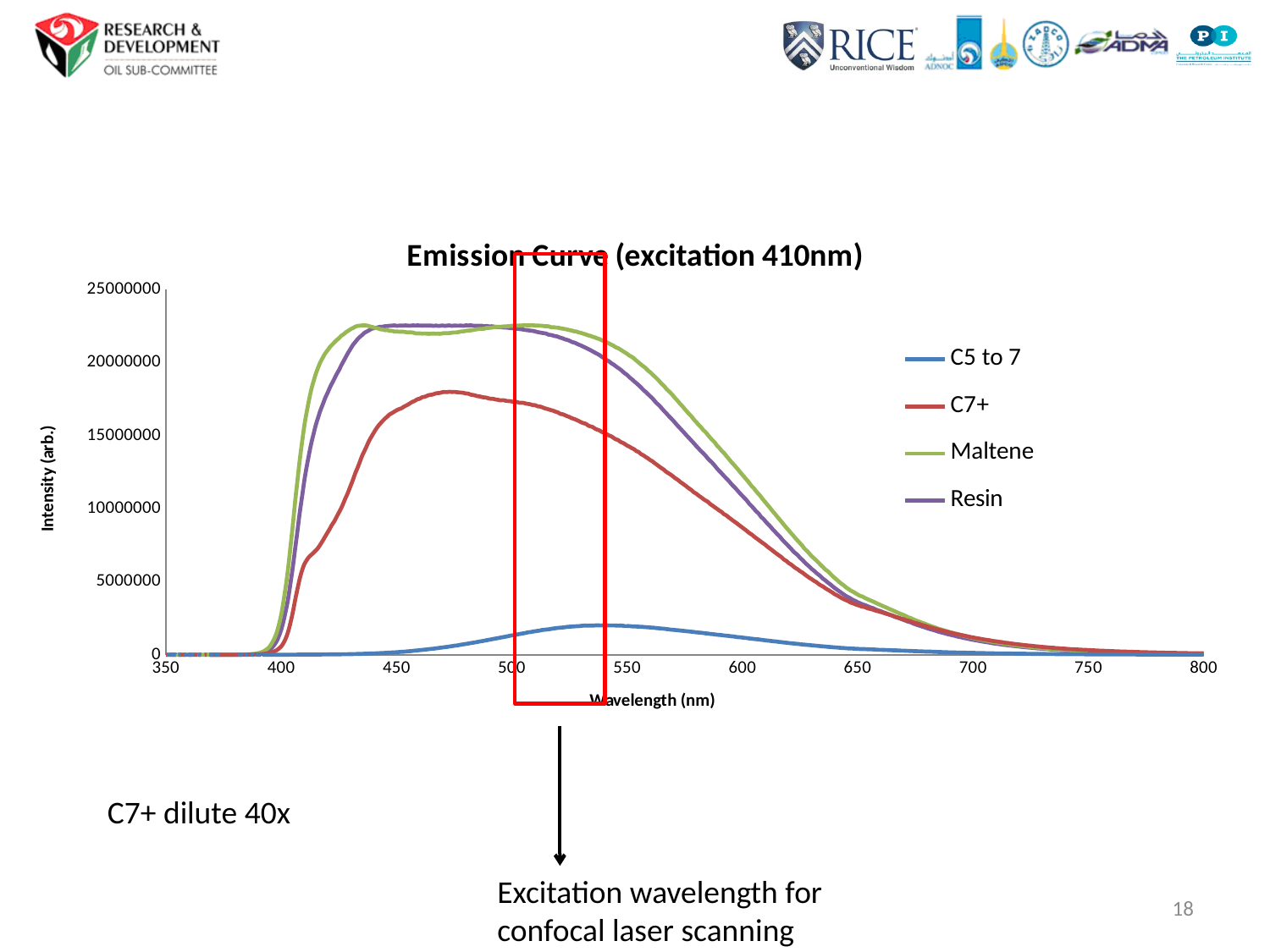
Is the intensity of the C7+ series at 600 nm greater or less than 15000000? less Is the intensity of the Resin series at 700 nm greater or less than 5000000? less Is the intensity of the Maltene series at 450 nm greater or less than 20000000? greater How many series does the legend of the chart list? 4 At 500 nm, which series has the higher intensity, Maltene or C7+? Maltene Which series has the lowest intensity across the wavelength range? C5 to 7 What kind of chart is shown on the slide? line chart At 550 nm, which series has the higher intensity, Resin or C5 to 7? Resin What is the label of the x axis of the chart? Wavelength (nm) What is the title of the chart? Emission Curve (excitation 410nm) Does the intensity of the C7+ series rise or fall between 500 nm and 700 nm? fall